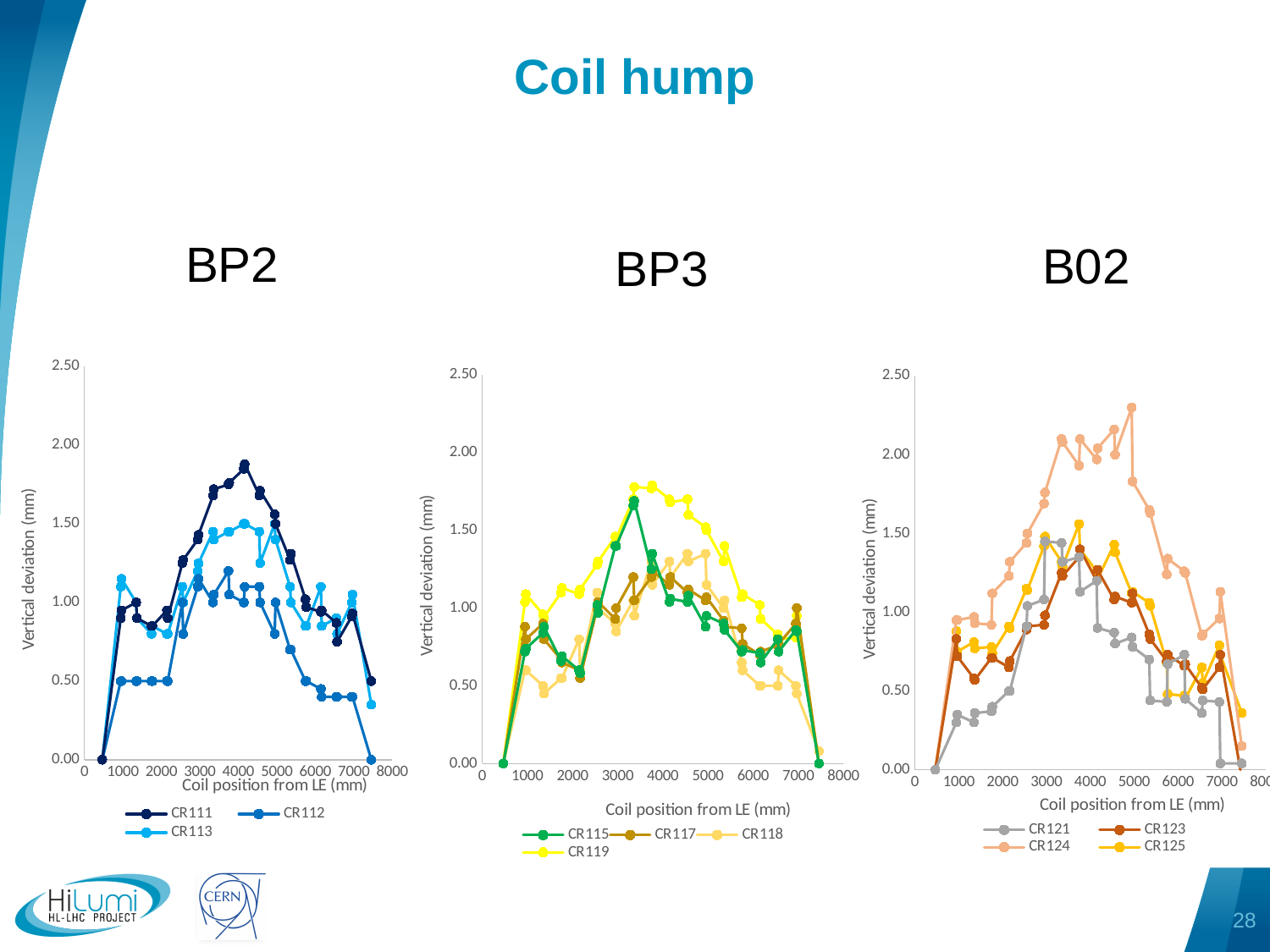
In the BP2 chart, is the peak value of CR112 greater or less than 1.50? less What is the x-axis title of the BP3 chart? Coil position from LE (mm) How many series does the legend of the B02 chart list? 4 In the B02 chart, is the peak value of CR124 greater or less than 2.00? greater In the BP2 chart, is the peak value of CR111 greater or less than 1.50? greater What kind of chart is the BP2 chart? line chart In the B02 chart, which series reaches the highest vertical deviation? CR124 How many series does the legend of the BP2 chart list? 3 In the BP2 chart, which series reaches the highest vertical deviation? CR111 How many series does the legend of the BP3 chart list? 4